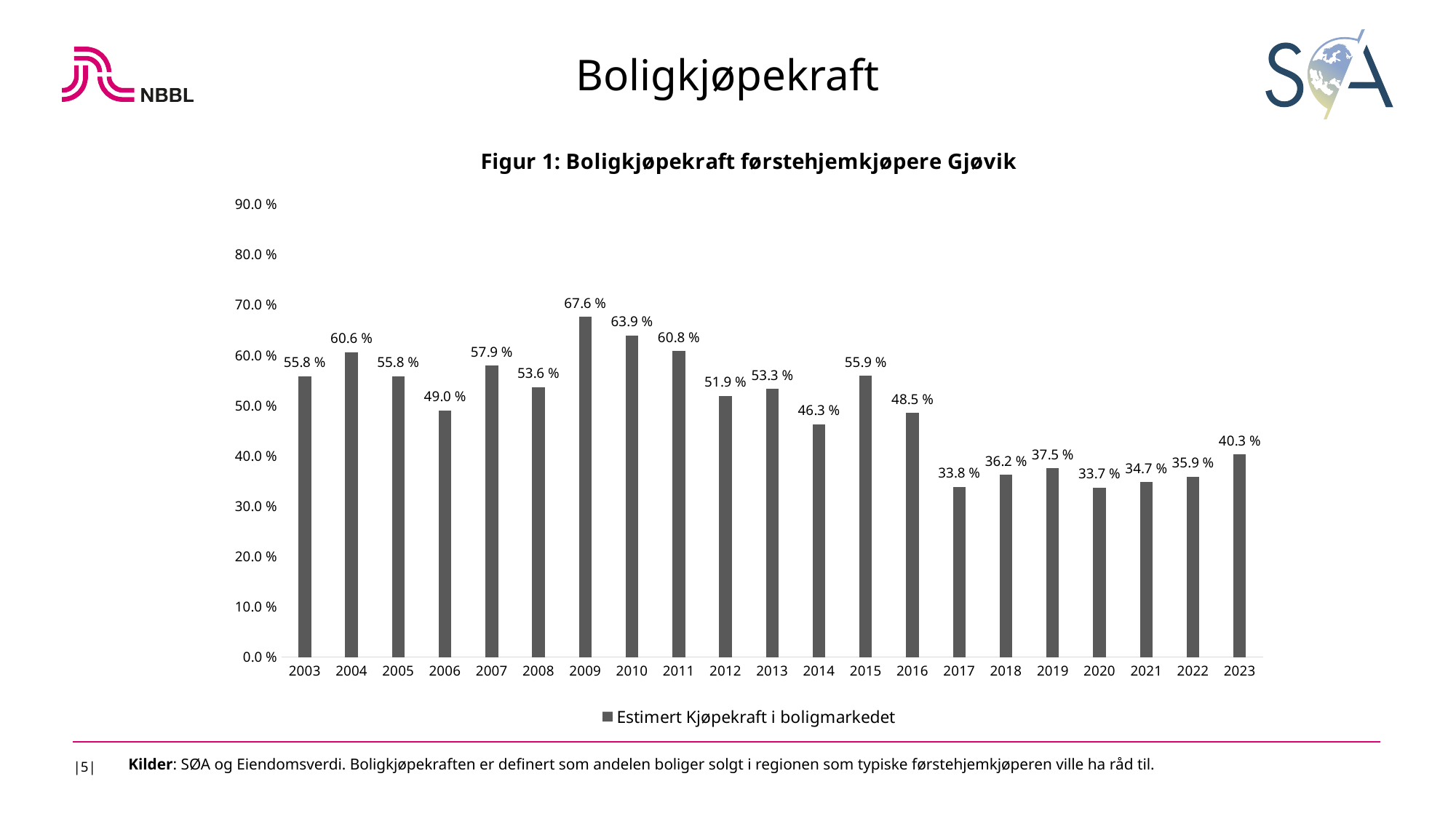
What is the value for 2009? 67.6 % How many series does the legend list? 1 Which is larger, the value for 2004 or the value for 2011? 2011 Which year has the lowest value? 2020 Is the value for 2017 greater or less than 40.0 %? less What is the value for 2014? 46.3 % How many years are shown on the x axis? 21 What is the difference between the values for 2009 and 2023? 27.3 % What kind of chart is shown? bar chart What is the value for 2023? 40.3 % Which year has the highest value? 2009 What is the legend entry for the series? Estimert Kjøpekraft i boligmarkedet